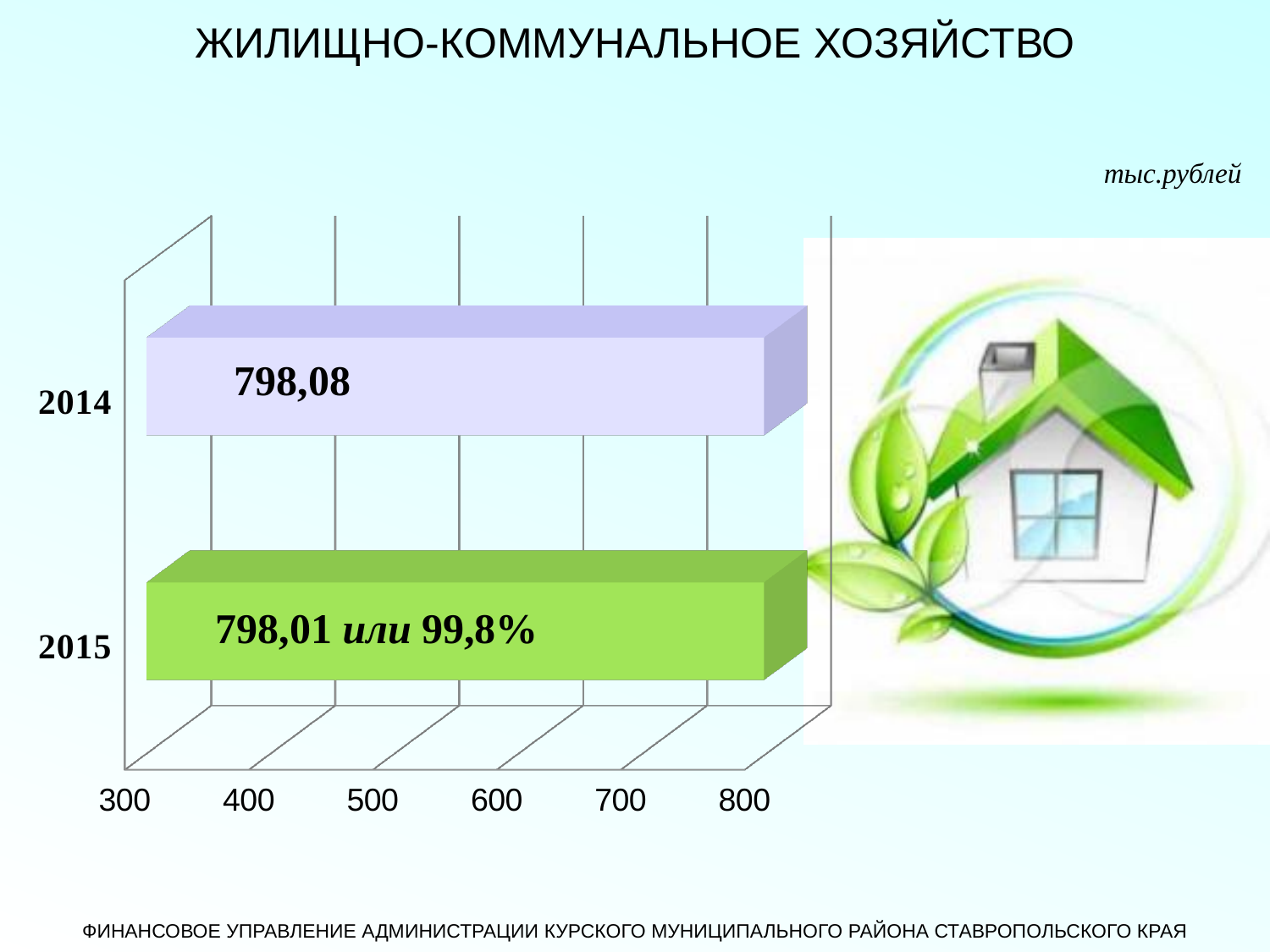
How many years (categories) are shown in the chart? 2 What is the lowest value shown on the horizontal axis? 300 What is the difference between the 2014 value and the 2015 value? 0,07 What is the title of the slide? ЖИЛИЩНО-КОММУНАЛЬНОЕ ХОЗЯЙСТВО Is the value for 2015 greater or less than 700? greater What percentage is shown next to the 2015 value? 99,8% What is the highest value shown on the horizontal axis? 800 In what units are the chart values given? тыс.рублей What is the value for 2015? 798,01 What is the value for 2014? 798,08 Is the value for 2014 greater or less than 600? greater What kind of chart is shown on the slide? bar chart